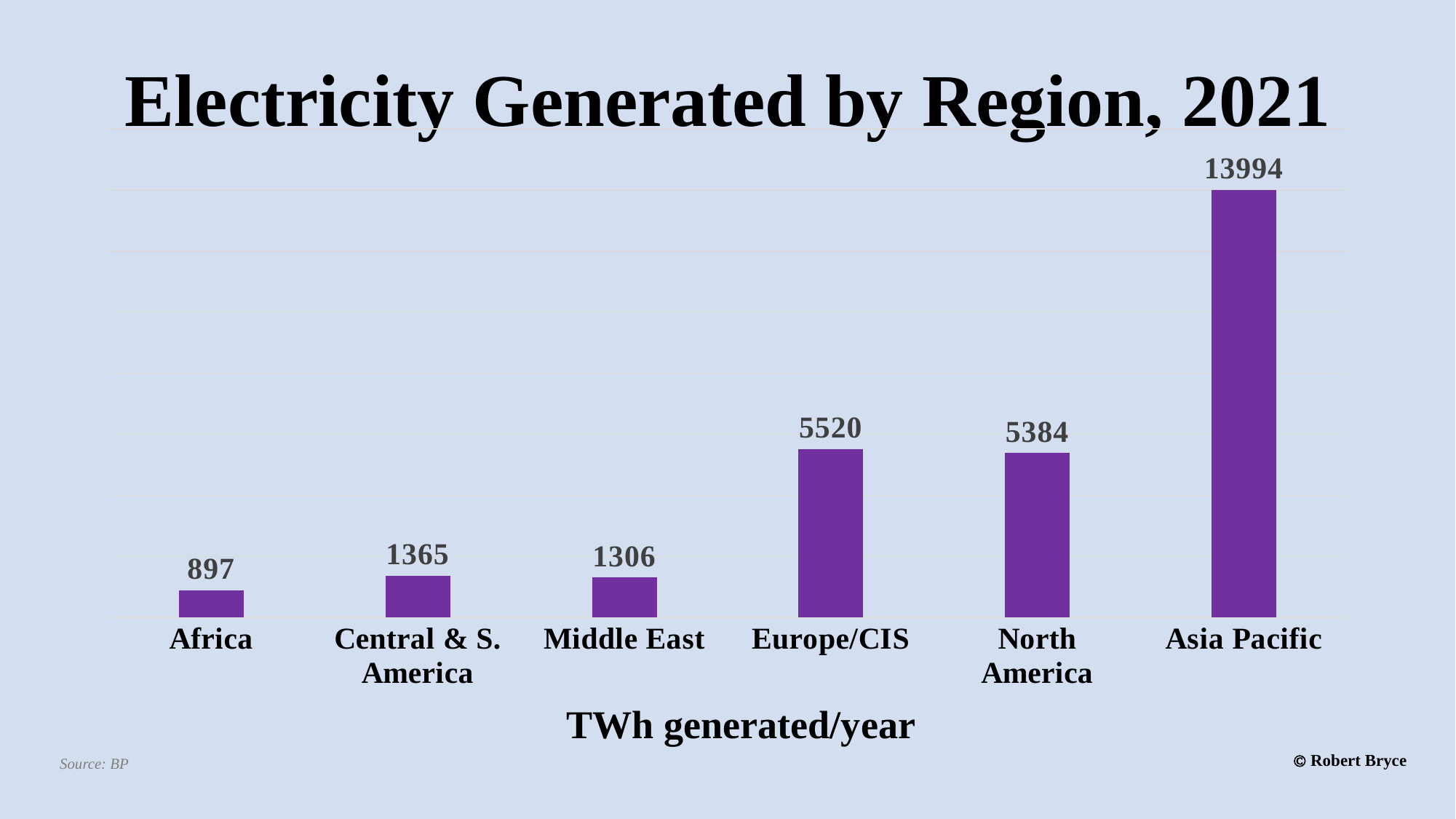
What is the difference between the values for Europe/CIS and North America? 136 What is the title of the chart? Electricity Generated by Region, 2021 Which region has the highest value? Asia Pacific What is the value for Central & S. America? 1365 What kind of chart is this? Bar chart Which region has the lowest value? Africa Which is larger, the value for Middle East or the value for North America? North America What is the value for Europe/CIS? 5520 What is the difference between the values for Central & S. America and Middle East? 59 What is the value for Africa? 897 How many regions are shown in the chart? 6 What is the value for Asia Pacific? 13994